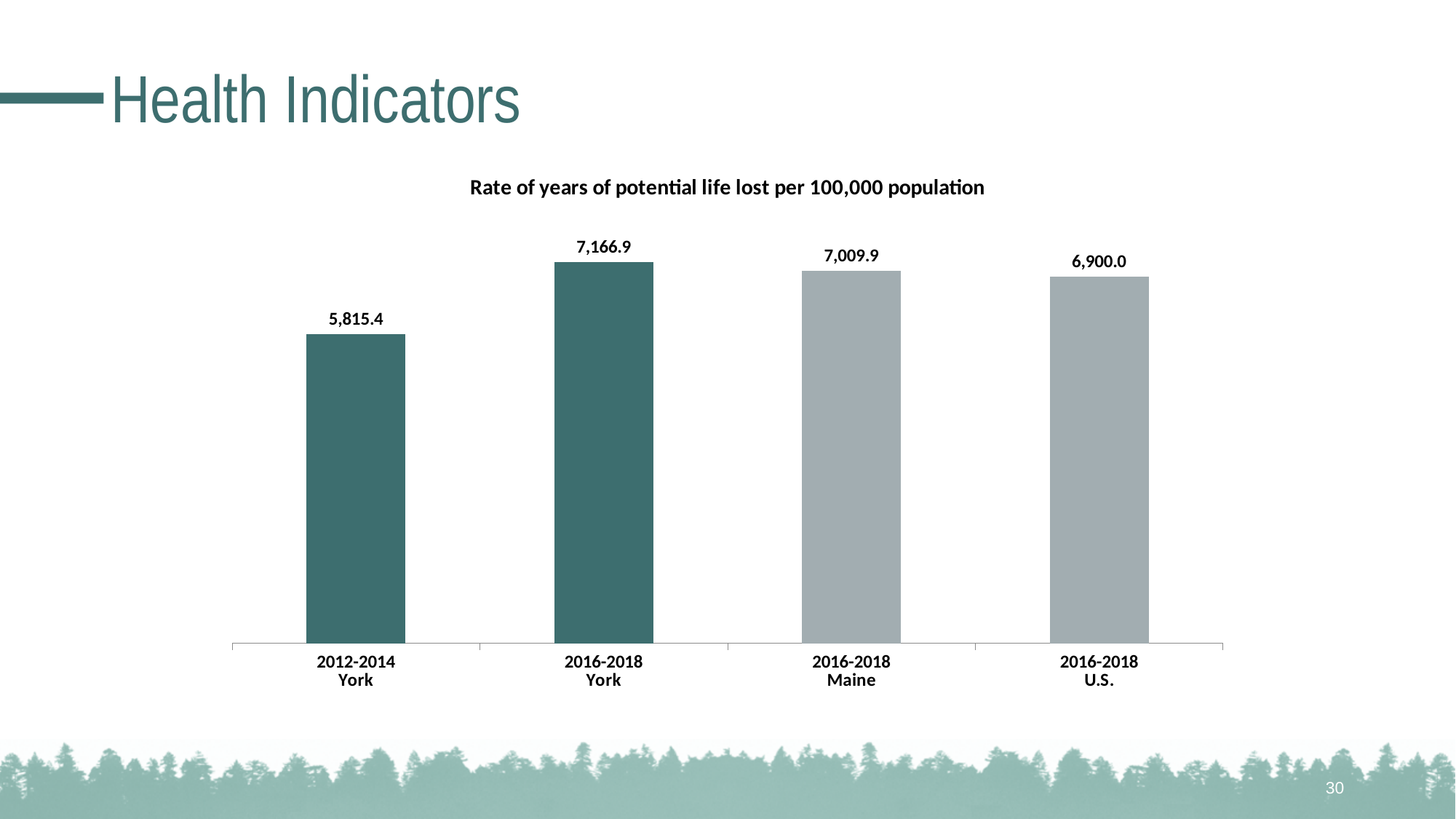
How many bars are shown in the chart? 4 What type of chart is shown on the slide? Bar chart In 2016-2018, which had a higher rate of years of potential life lost, York or Maine? York What is the rate of years of potential life lost per 100,000 population for the U.S. in 2016-2018? 6,900.0 What is the title of the chart? Rate of years of potential life lost per 100,000 population What is the rate of years of potential life lost per 100,000 population for York in 2012-2014? 5,815.4 What is the rate of years of potential life lost per 100,000 population for Maine in 2016-2018? 7,009.9 What is the difference between the 2016-2018 rates for Maine and the U.S.? 109.9 What is the rate of years of potential life lost per 100,000 population for York in 2016-2018? 7,166.9 By how much did York's rate of years of potential life lost increase from 2012-2014 to 2016-2018? 1,351.5 Which bar has the lowest rate of years of potential life lost? 2012-2014 York Which bar has the highest rate of years of potential life lost? 2016-2018 York